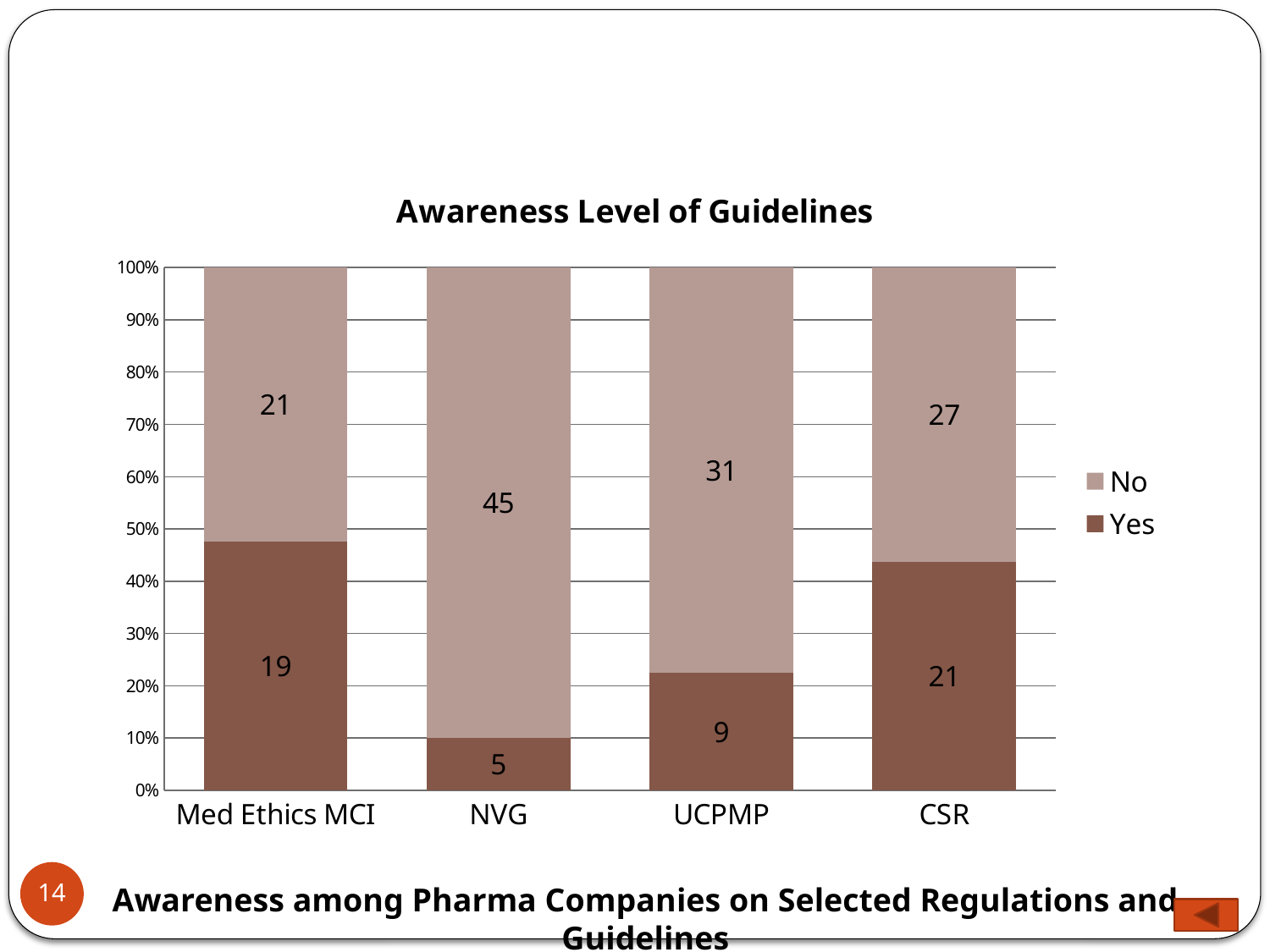
What is the title of the chart? Awareness Level of Guidelines Which is larger, the 'Yes' value for UCPMP or the 'Yes' value for Med Ethics MCI? Med Ethics MCI What is the 'No' value for UCPMP? 31 How many categories are shown on the x axis of the chart? 4 Which category has the lowest 'Yes' value? NVG What is the 'Yes' value for NVG? 5 What type of chart is shown on the slide? Stacked bar chart How many series does the chart's legend list? 2 What is the total of the 'Yes' and 'No' values for NVG? 50 Which category has the highest 'No' value? NVG What is the difference between the 'No' and 'Yes' values for Med Ethics MCI? 2 What is the 'Yes' value for CSR? 21